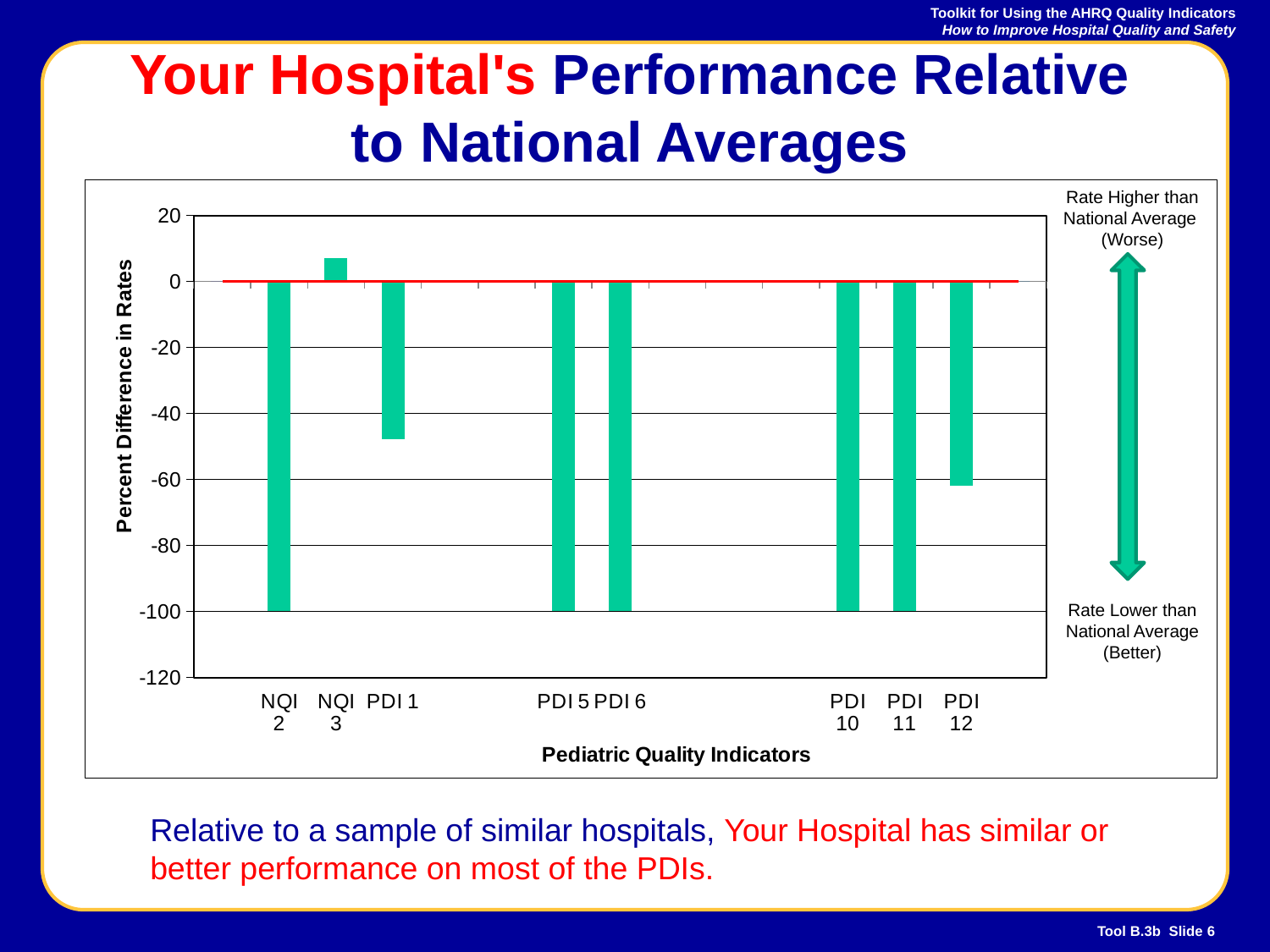
Which has the higher value, PDI 1 or PDI 12? PDI 1 What type of chart is shown on the slide? bar chart What is the title of the y axis of the chart? Percent Difference in Rates Is the value for PDI 1 greater or less than -40? less Is the value for NQI 3 greater or less than 0? greater Which indicator has the highest value in the chart? NQI 3 What is the title of the x axis of the chart? Pediatric Quality Indicators What is the value for PDI 11? -100 What is the value for NQI 2? -100 How many labeled indicators are shown on the x axis of the chart? 8 What is the value for PDI 5? -100 Is the value for PDI 12 greater or less than -80? greater